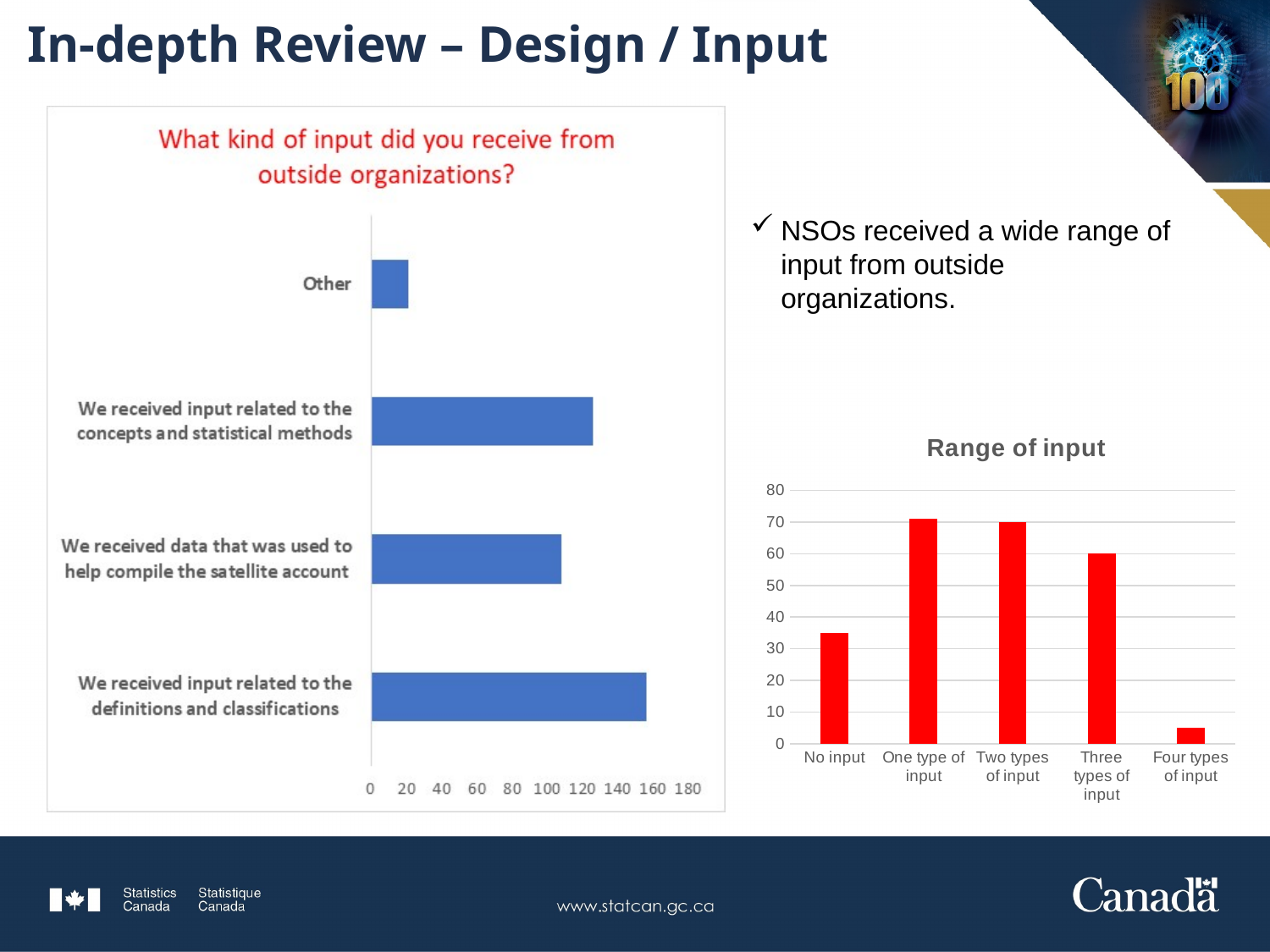
In the 'What kind of input did you receive from outside organizations?' chart, is the value for 'Other' greater or less than 40? less In the 'Range of input' chart, is the value for 'Three types of input' greater or less than 50? greater In the 'What kind of input did you receive from outside organizations?' chart, which is larger: the value for 'We received input related to the definitions and classifications' or 'We received input related to the concepts and statistical methods'? We received input related to the definitions and classifications In the 'Range of input' chart, is the value for 'No input' greater or less than 40? less What kind of chart is the 'Range of input' chart on the right of the slide? bar chart In the 'What kind of input did you receive from outside organizations?' chart, which category has the highest value? We received input related to the definitions and classifications How many categories are shown in the 'Range of input' chart? 5 In the 'Range of input' chart, which is larger: the value for 'Three types of input' or 'No input'? Three types of input How many categories are shown in the 'What kind of input did you receive from outside organizations?' chart? 4 In the 'What kind of input did you receive from outside organizations?' chart, which category has the lowest value? Other In the 'Range of input' chart, which category has the lowest value? Four types of input